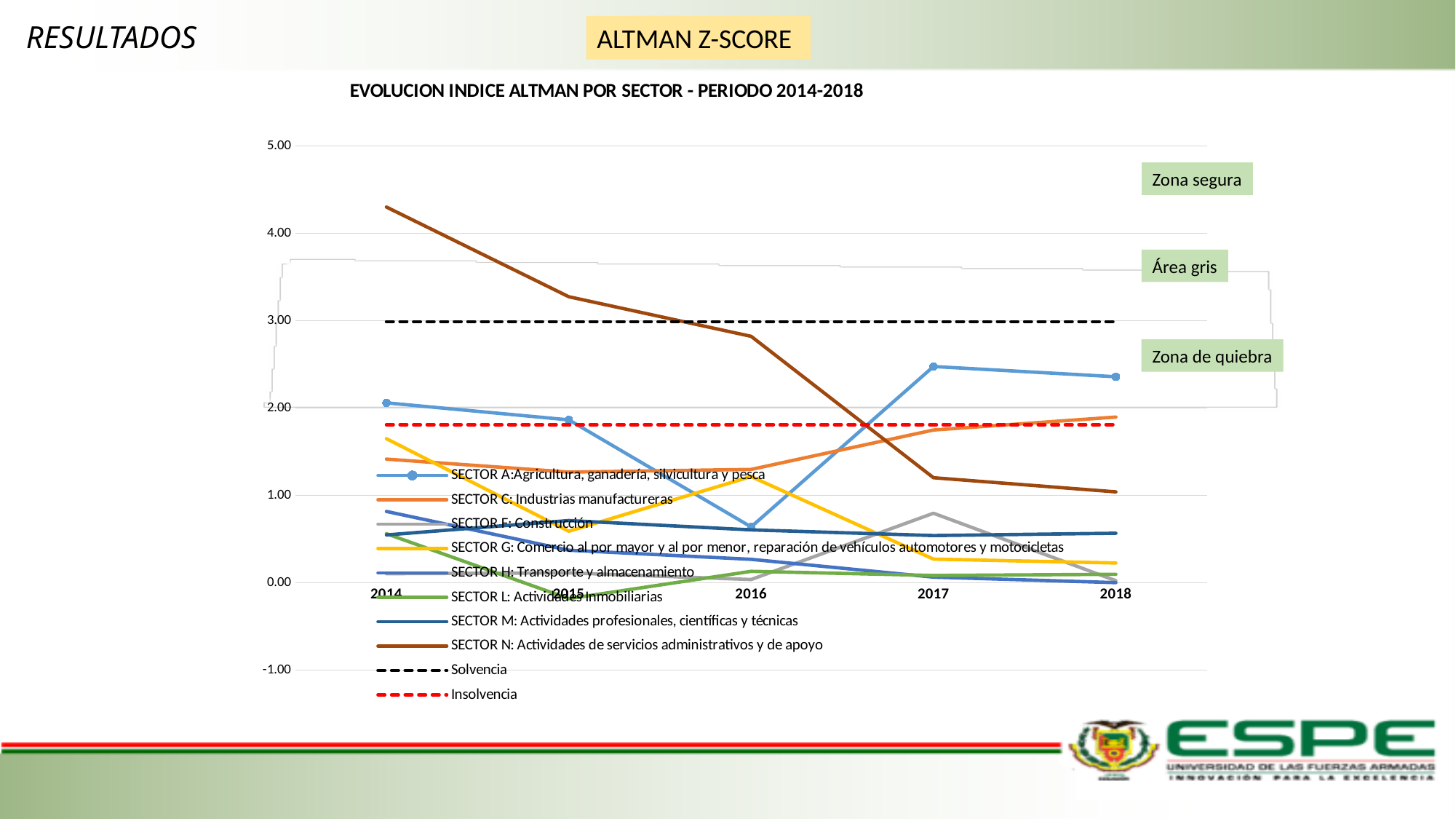
In 2018, which is larger: the value for SECTOR A: Agricultura, ganadería, silvicultura y pesca or for SECTOR C: Industrias manufactureras? SECTOR A: Agricultura, ganadería, silvicultura y pesca What does the black dashed horizontal line represent according to the legend? Solvencia What kind of chart is shown on the slide? line chart How many years are plotted along the x axis? 5 Is the value for SECTOR N: Actividades de servicios administrativos y de apoyo in 2016 greater or less than 3.00? less Is the value for SECTOR N: Actividades de servicios administrativos y de apoyo in 2014 greater or less than 4.00? greater Is the value for SECTOR A: Agricultura, ganadería, silvicultura y pesca in 2017 greater or less than 2.00? greater Which sector has the highest value in 2014? SECTOR N: Actividades de servicios administrativos y de apoyo Does the line for SECTOR C: Industrias manufactureras rise or fall from 2015 to 2018? rise How many entries does the legend list? 10 Does the line for SECTOR N: Actividades de servicios administrativos y de apoyo rise or fall from 2014 to 2018? fall